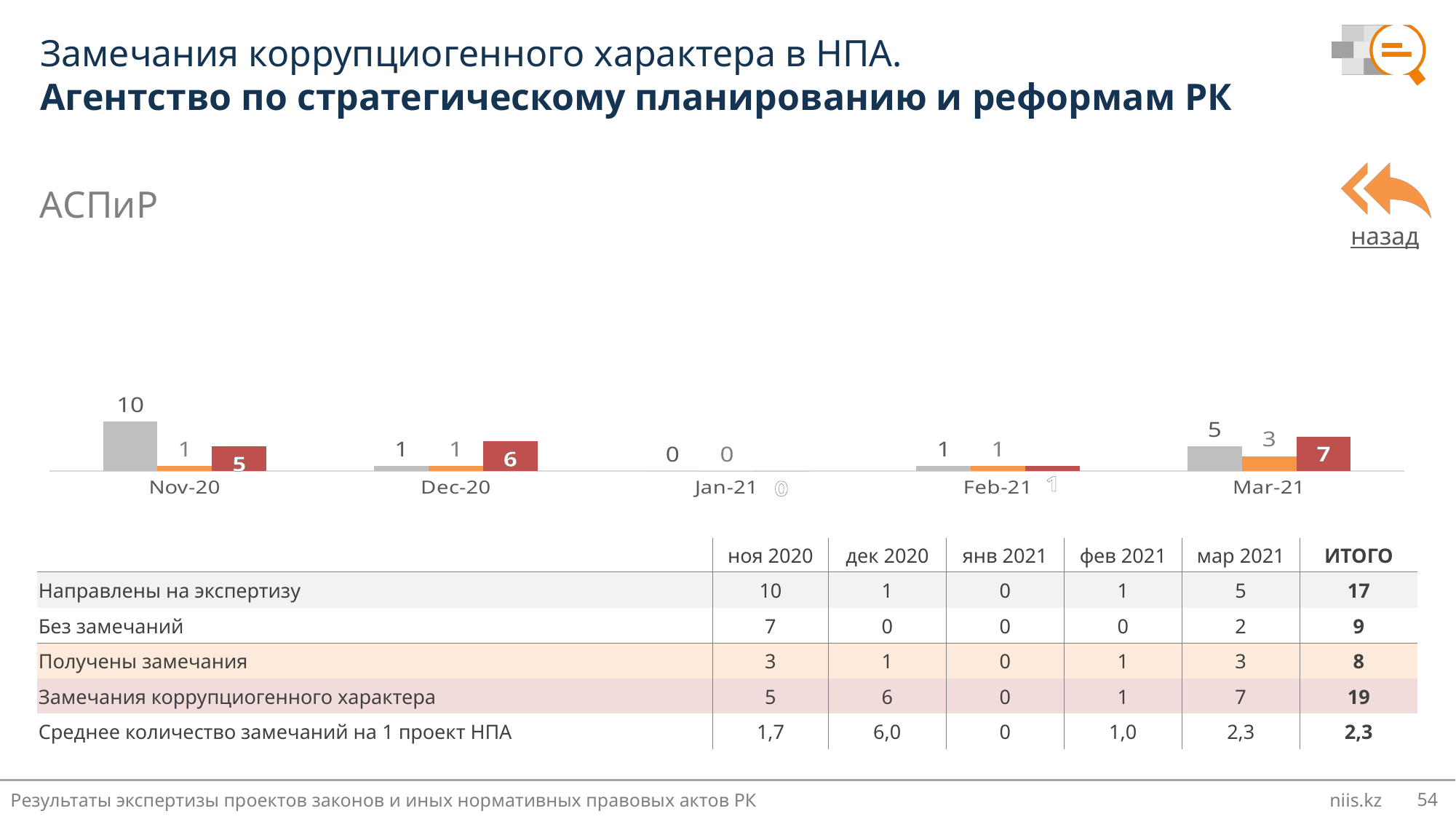
What is the value of the red bar for Mar-21 in the chart? 7 In which period does the gray bar reach its highest value in the chart? Nov-20 What is the value of the red bar for Dec-20 in the chart? 6 What is the value of the gray bar for Nov-20 in the chart? 10 What type of chart is shown on the slide? bar chart Which is larger in the chart: the red bar for Nov-20 or the red bar for Dec-20? Dec-20 What is the value of the orange bar for Mar-21 in the chart? 3 How many time periods (categories) are shown on the x axis of the chart? 5 What is the value of the gray bar for Jan-21 in the chart? 0 In which period does the red bar reach its highest value in the chart? Mar-21 What is the difference between the red bar and the orange bar for Mar-21 in the chart? 4 What is the difference between the gray bar value for Nov-20 and the gray bar value for Mar-21? 5